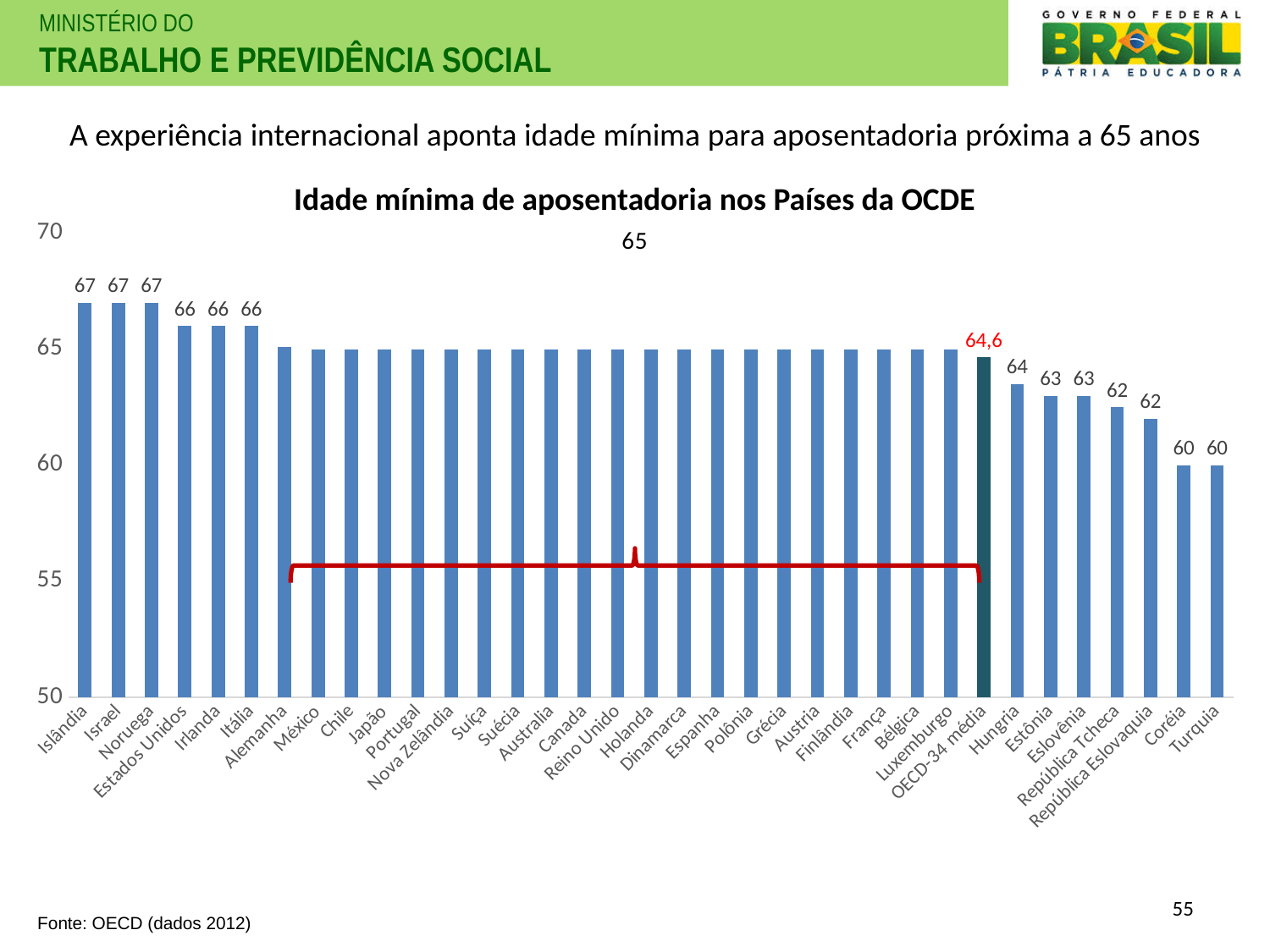
What is the lowest minimum retirement age shown in the chart? 60 What is the minimum retirement age shown for Islândia? 67 What kind of chart is shown on the slide? bar chart Is the value for Estônia greater or less than 65? less What is the difference between the values for Islândia and Turquia? 7 What value is shown for OECD-34 média? 64,6 What is the highest minimum retirement age shown in the chart? 67 What is the value shown for Hungria? 64 What is the value shown for República Tcheca? 62 Is the value for Irlanda greater or less than 65? greater Which has a higher value, Estados Unidos or Hungria? Estados Unidos What is the title of the chart? Idade mínima de aposentadoria nos Países da OCDE